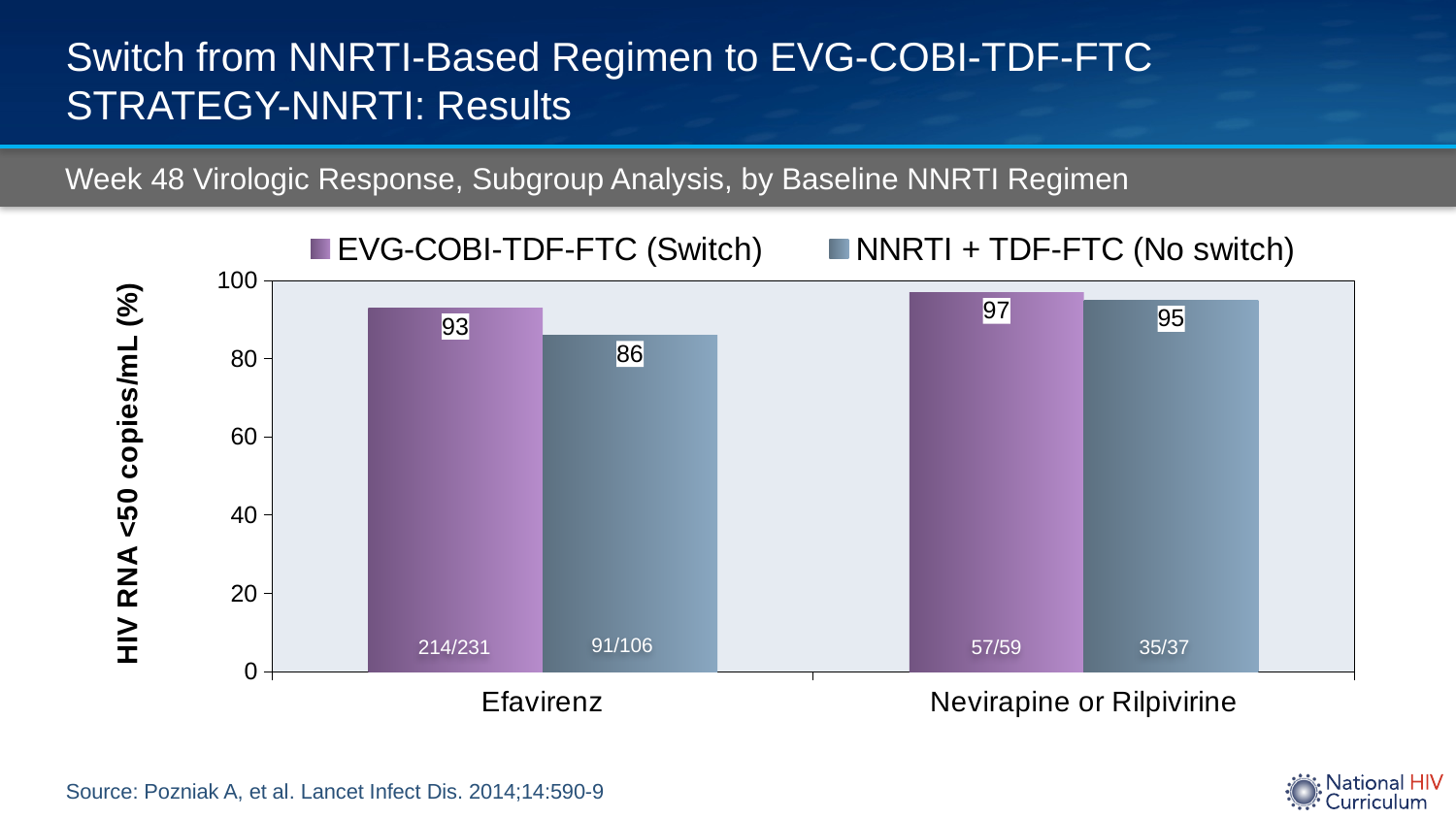
Which bar has the highest value on the chart? EVG-COBI-TDF-FTC (Switch), Nevirapine or Rilpivirine What is the label of the y axis? HIV RNA <50 copies/mL (%) What is the value for NNRTI + TDF-FTC (No switch) in the Efavirenz group? 86 What is the difference between the EVG-COBI-TDF-FTC (Switch) and NNRTI + TDF-FTC (No switch) values in the Efavirenz group? 7 Which bar has the lowest value on the chart? NNRTI + TDF-FTC (No switch), Efavirenz What is the value for EVG-COBI-TDF-FTC (Switch) in the Efavirenz group? 93 In the Efavirenz group, which series has the larger value: EVG-COBI-TDF-FTC (Switch) or NNRTI + TDF-FTC (No switch)? EVG-COBI-TDF-FTC (Switch) What is the value for NNRTI + TDF-FTC (No switch) in the Nevirapine or Rilpivirine group? 95 How many categories are shown on the x axis? 2 How many series does the legend list? 2 What kind of chart is shown on the slide? Bar chart What is the value for EVG-COBI-TDF-FTC (Switch) in the Nevirapine or Rilpivirine group? 97